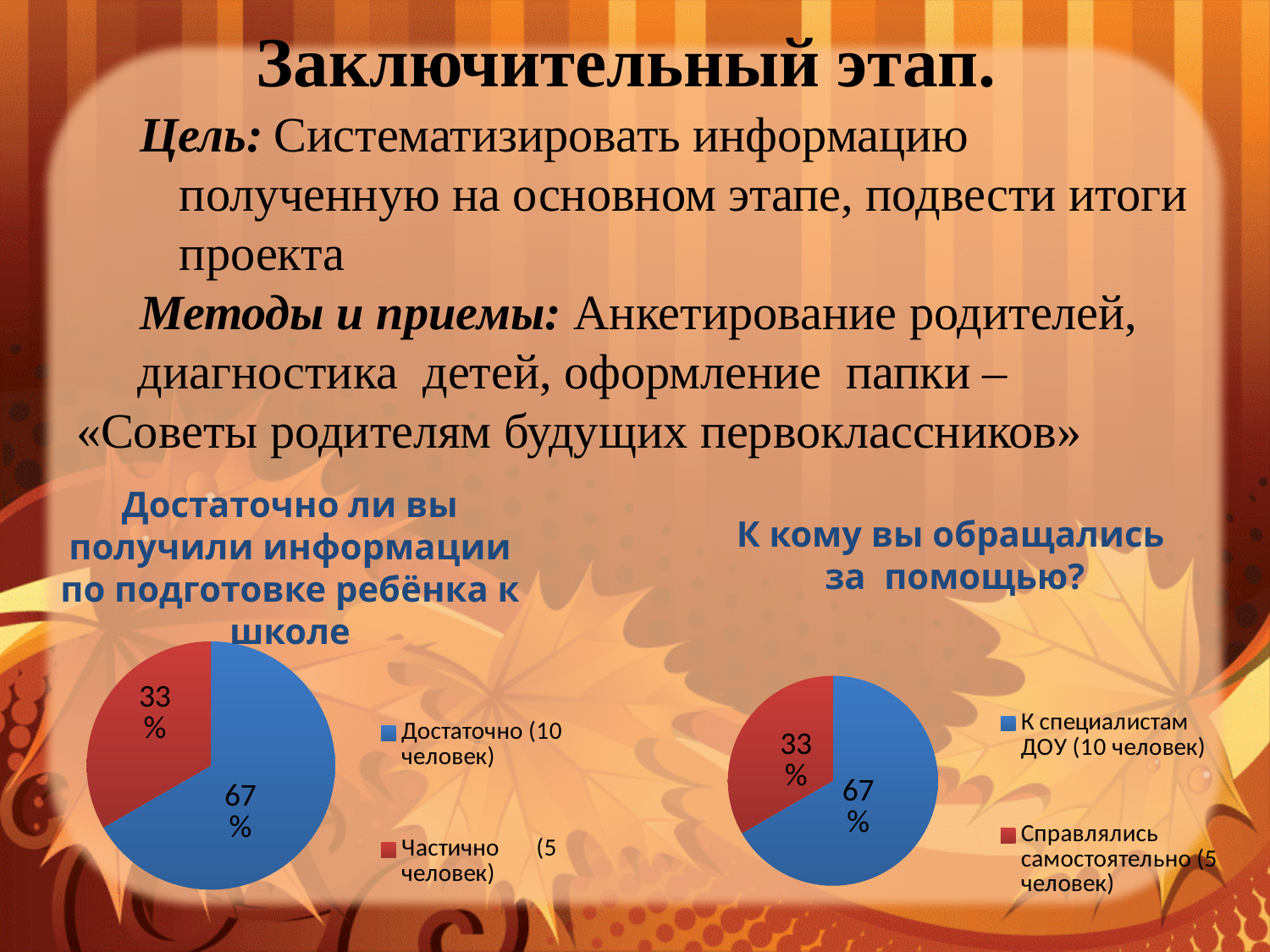
In the right pie chart ("К кому вы обращались за помощью?"), what share is labelled for "Справлялись самостоятельно (5 человек)"? 33% In the right pie chart ("К кому вы обращались за помощью?"), what is the difference in percentage points between the "К специалистам ДОУ" slice and the "Справлялись самостоятельно" slice? 34 percentage points In the right pie chart ("К кому вы обращались за помощью?"), what share is labelled for "К специалистам ДОУ (10 человек)"? 67% In the left pie chart ("Достаточно ли вы получили информации..."), which slice is the largest? Достаточно (10 человек) How many slices does the left pie chart ("Достаточно ли вы получили информации...") have? 2 In the left pie chart ("Достаточно ли вы получили информации..."), which is larger: the "Достаточно" slice or the "Частично" slice? Достаточно In the right pie chart ("К кому вы обращались за помощью?"), which slice is the smallest? Справлялись самостоятельно (5 человек) How many entries does the legend of the right pie chart ("К кому вы обращались за помощью?") list? 2 In the left pie chart ("Достаточно ли вы получили информации..."), what share is labelled for "Достаточно (10 человек)"? 67% What kind of chart is the left chart, titled "Достаточно ли вы получили информации по подготовке ребёнка к школе"? Pie chart In the right pie chart ("К кому вы обращались за помощью?"), what colour is the "К специалистам ДОУ (10 человек)" slice? Blue